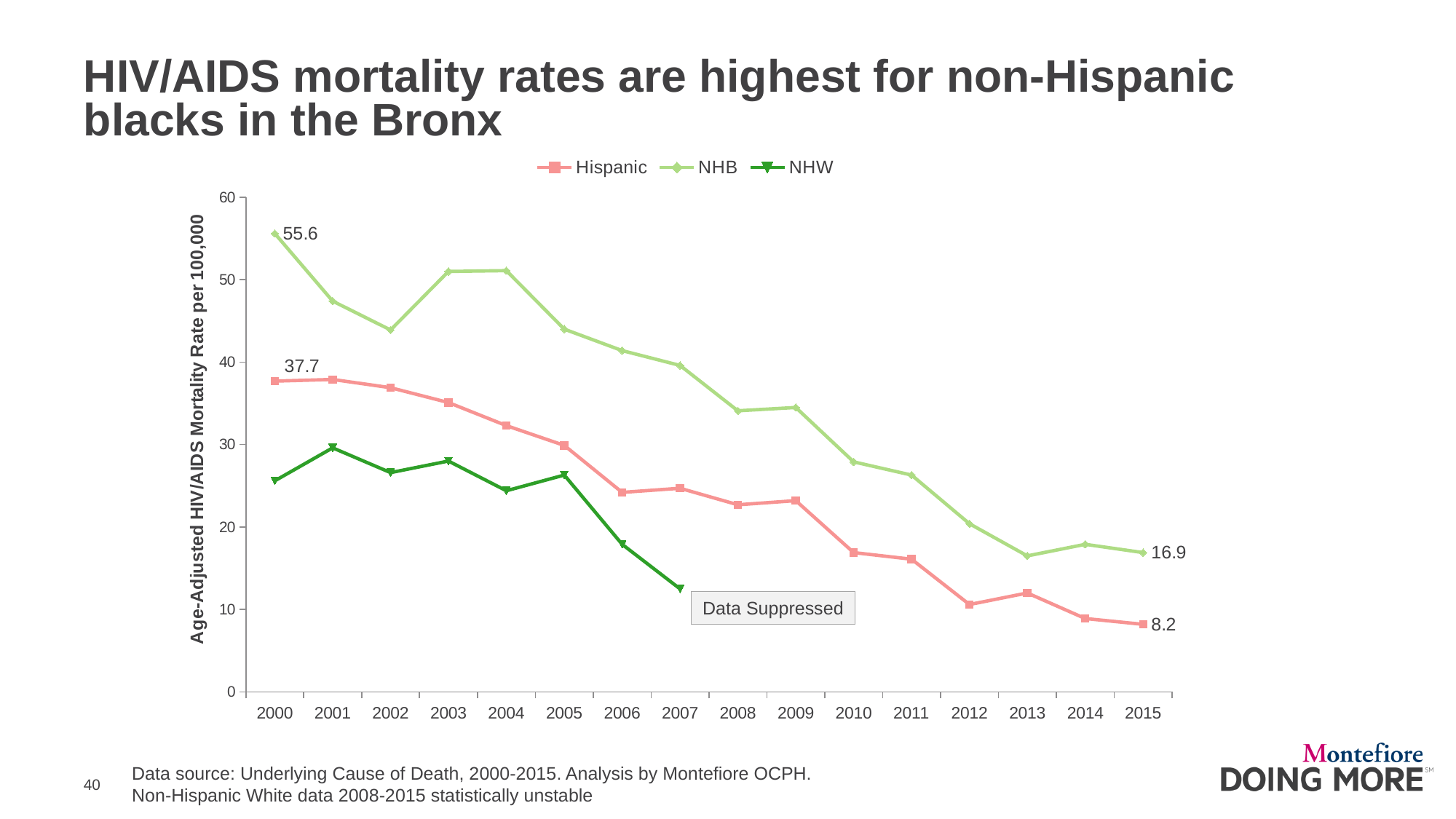
What is the Hispanic HIV/AIDS mortality rate in 2000? 37.7 Does the NHB mortality rate generally rise or fall from 2000 to 2015? Fall What is the Hispanic HIV/AIDS mortality rate in 2015? 8.2 What is the NHB HIV/AIDS mortality rate in 2000? 55.6 What is the NHB HIV/AIDS mortality rate in 2015? 16.9 Which series has the higher mortality rate in 2015, NHB or Hispanic? NHB How many series does the legend list? 3 Is the NHW value for 2007 greater or less than 20? less What is the difference between the NHB and Hispanic mortality rates in 2000? 17.9 How many years are shown on the x axis? 16 By how much did the NHB mortality rate fall from 2000 to 2015? 38.7 What kind of chart is shown on the slide? Line chart